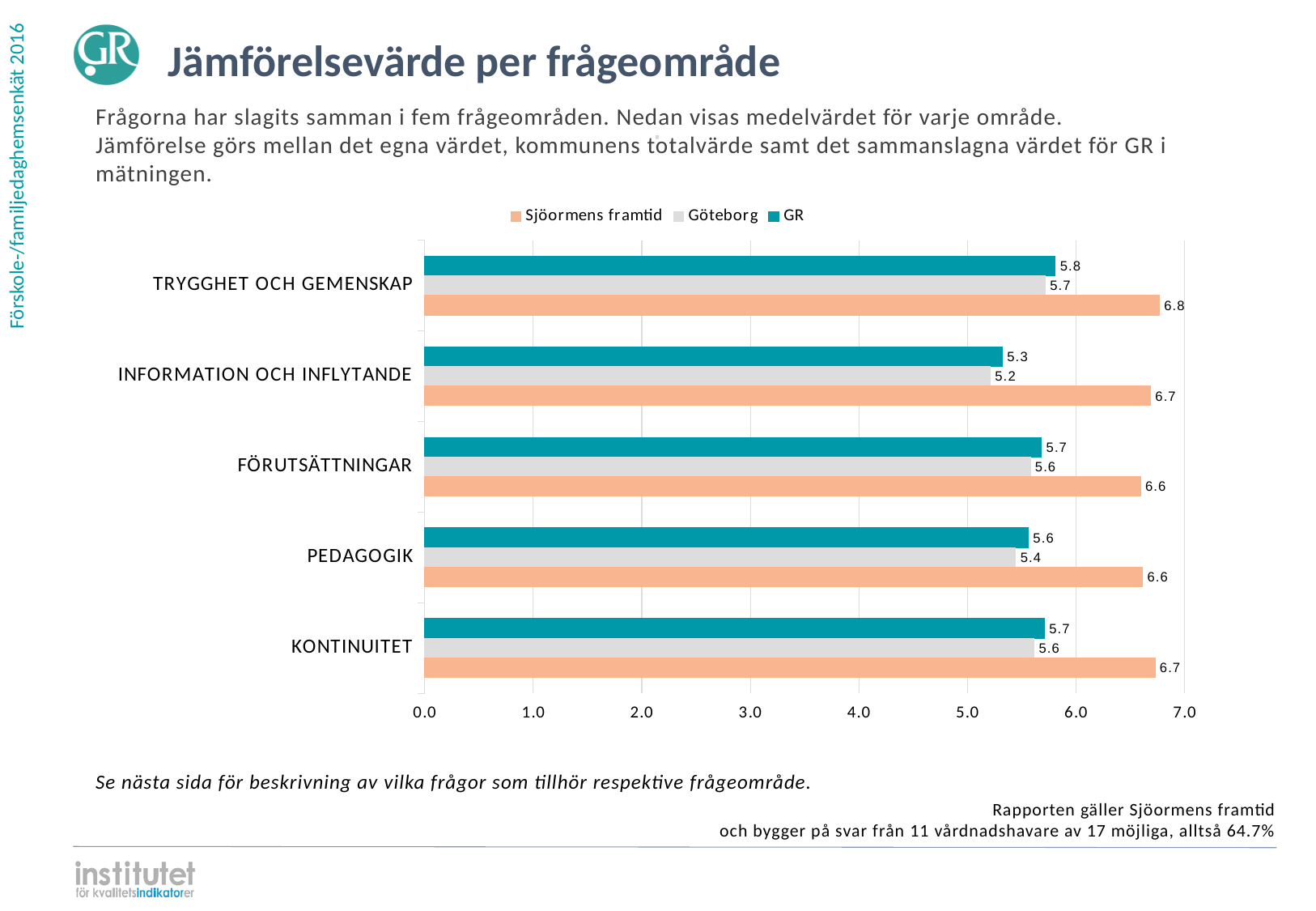
What is the value for Göteborg in the INFORMATION OCH INFLYTANDE category? 5.2 What is the value for Sjöormens framtid in the TRYGGHET OCH GEMENSKAP category? 6.8 What is the title of the slide's chart section? Jämförelsevärde per frågeområde Which is larger for KONTINUITET: the Sjöormens framtid value or the GR value? Sjöormens framtid Which series is shown in orange in the legend? Sjöormens framtid What is the value for GR in the PEDAGOGIK category? 5.6 Which category has the highest value for Sjöormens framtid? TRYGGHET OCH GEMENSKAP What kind of chart is shown on the slide? Bar chart What is the difference between the Sjöormens framtid value and the Göteborg value for INFORMATION OCH INFLYTANDE? 1.5 How many categories are shown on the chart? 5 How many series does the legend list? 3 Which category has the lowest value for GR? INFORMATION OCH INFLYTANDE